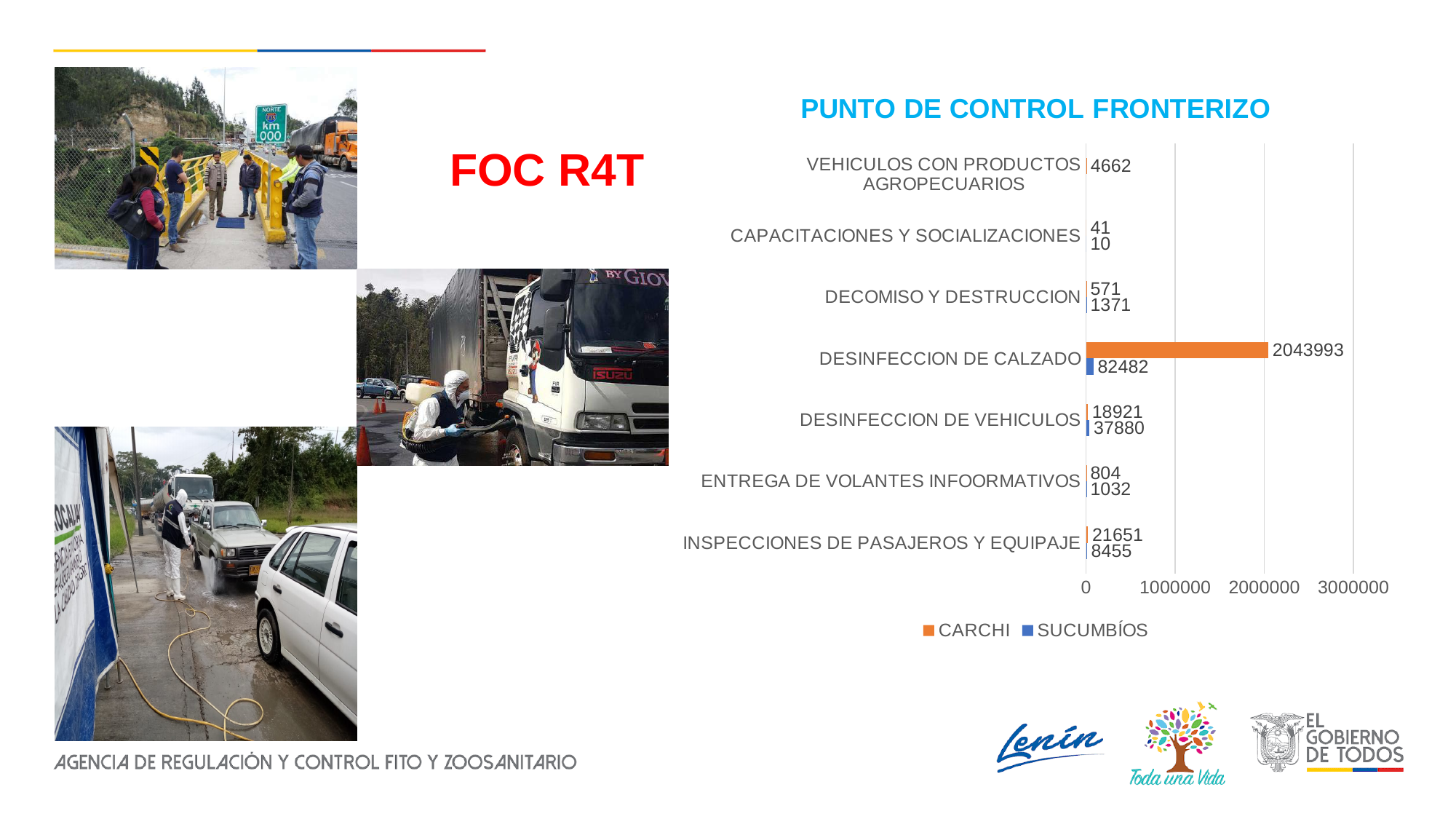
What type of chart is shown under the title PUNTO DE CONTROL FRONTERIZO? bar chart What is the SUCUMBÍOS value for DESINFECCION DE VEHICULOS? 37880 Which colour represents the CARCHI series in the legend? orange What is the CARCHI value for DESINFECCION DE CALZADO? 2043993 What is the SUCUMBÍOS value for DESINFECCION DE CALZADO? 82482 For ENTREGA DE VOLANTES INFOORMATIVOS, which series has the larger value, CARCHI or SUCUMBÍOS? SUCUMBÍOS What is the CARCHI value for INSPECCIONES DE PASAJEROS Y EQUIPAJE? 21651 Which category has the highest CARCHI value? DESINFECCION DE CALZADO What is the difference between the CARCHI and SUCUMBÍOS values for DECOMISO Y DESTRUCCION? 800 How many categories are shown on the PUNTO DE CONTROL FRONTERIZO chart? 7 Which category has the lowest SUCUMBÍOS value? CAPACITACIONES Y SOCIALIZACIONES How many series does the legend of the PUNTO DE CONTROL FRONTERIZO chart list? 2